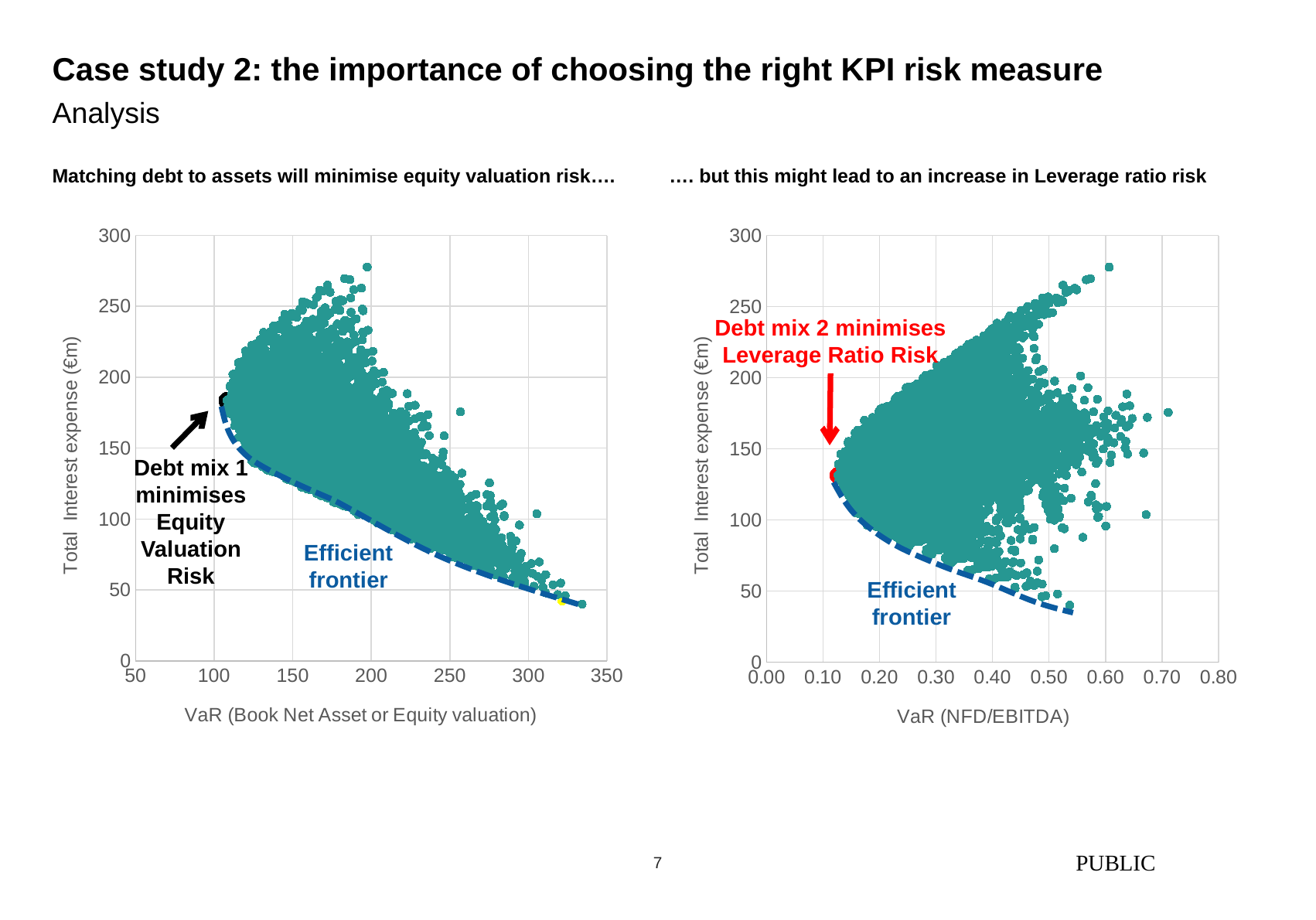
On the left chart, what is the label of the x axis? VaR (Book Net Asset or Equity valuation) On the right chart, is the Total Interest expense for the point marked 'Debt mix 2' greater or less than 150? less What kind of chart is the right chart, titled '…. but this might lead to an increase in Leverage ratio risk'? scatter chart On the left chart, is the highest Total Interest expense plotted greater or less than 250? greater On the left chart, does Total Interest expense along the dashed efficient frontier rise or fall as VaR increases? fall On the right chart, is the VaR (NFD/EBITDA) value for the point marked 'Debt mix 2' greater or less than 0.20? less What kind of chart is the left chart, titled 'Matching debt to assets will minimise equity valuation risk….'? scatter chart How many charts are shown on the slide? 2 On the right chart, what is the label of the x axis? VaR (NFD/EBITDA)